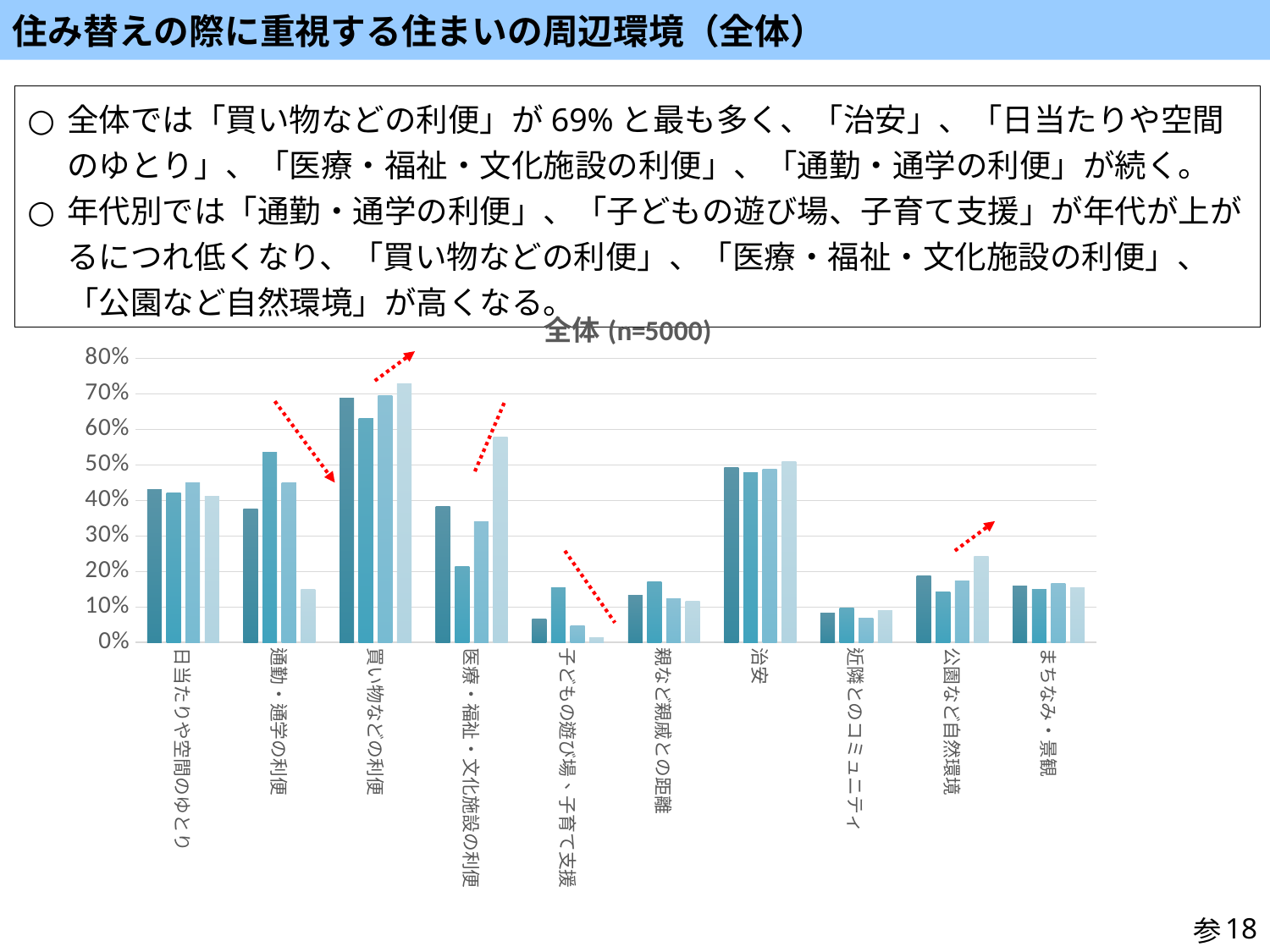
Which category has higher bars, 治安 or 親など親戚との距離? 治安 Which category has the highest bars in the chart? 買い物などの利便 Is the value of the fourth bar for 医療・福祉・文化施設の利便 greater or less than 50%? greater Is the value of the fourth bar for 子どもの遊び場、子育て支援 greater or less than 10%? less Is the value of the first bar for 買い物などの利便 greater or less than 60%? greater How many categories are shown on the x axis of the chart? 10 What is the maximum value shown on the y axis of the chart? 80% What is the title of the chart? 全体 (n=5000) What kind of chart is shown on the slide? bar chart